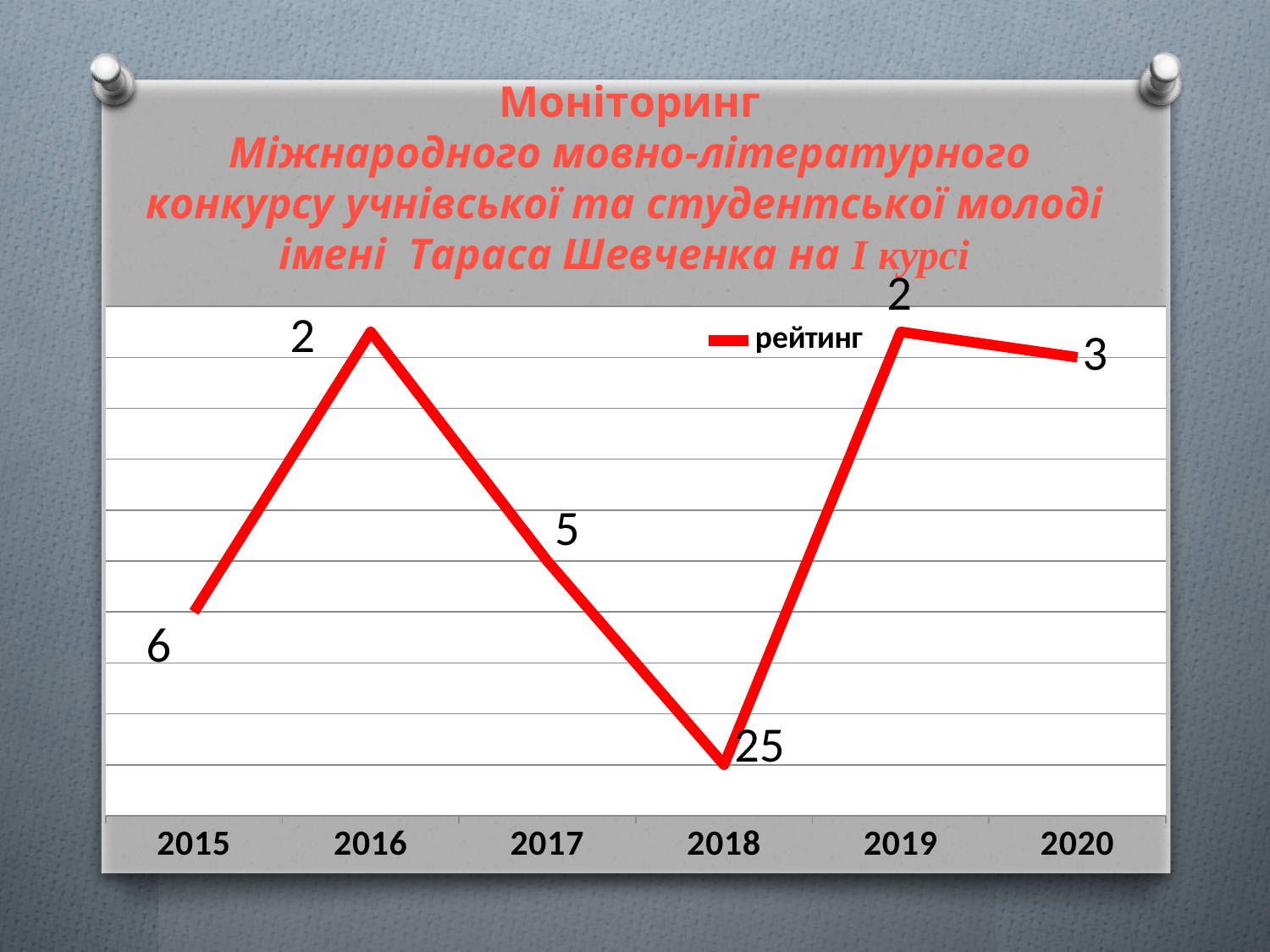
What is the value for 2020? 3 What is the value for 2015? 6 What is the difference between the values for 2018 and 2017? 20 How many series does the legend list? 1 What is the difference between the values for 2015 and 2020? 3 What kind of chart is shown on the slide? line chart What is the value for 2018? 25 What is the name of the series shown in the legend? рейтинг What is the value for 2017? 5 How many years are plotted on the x axis? 6